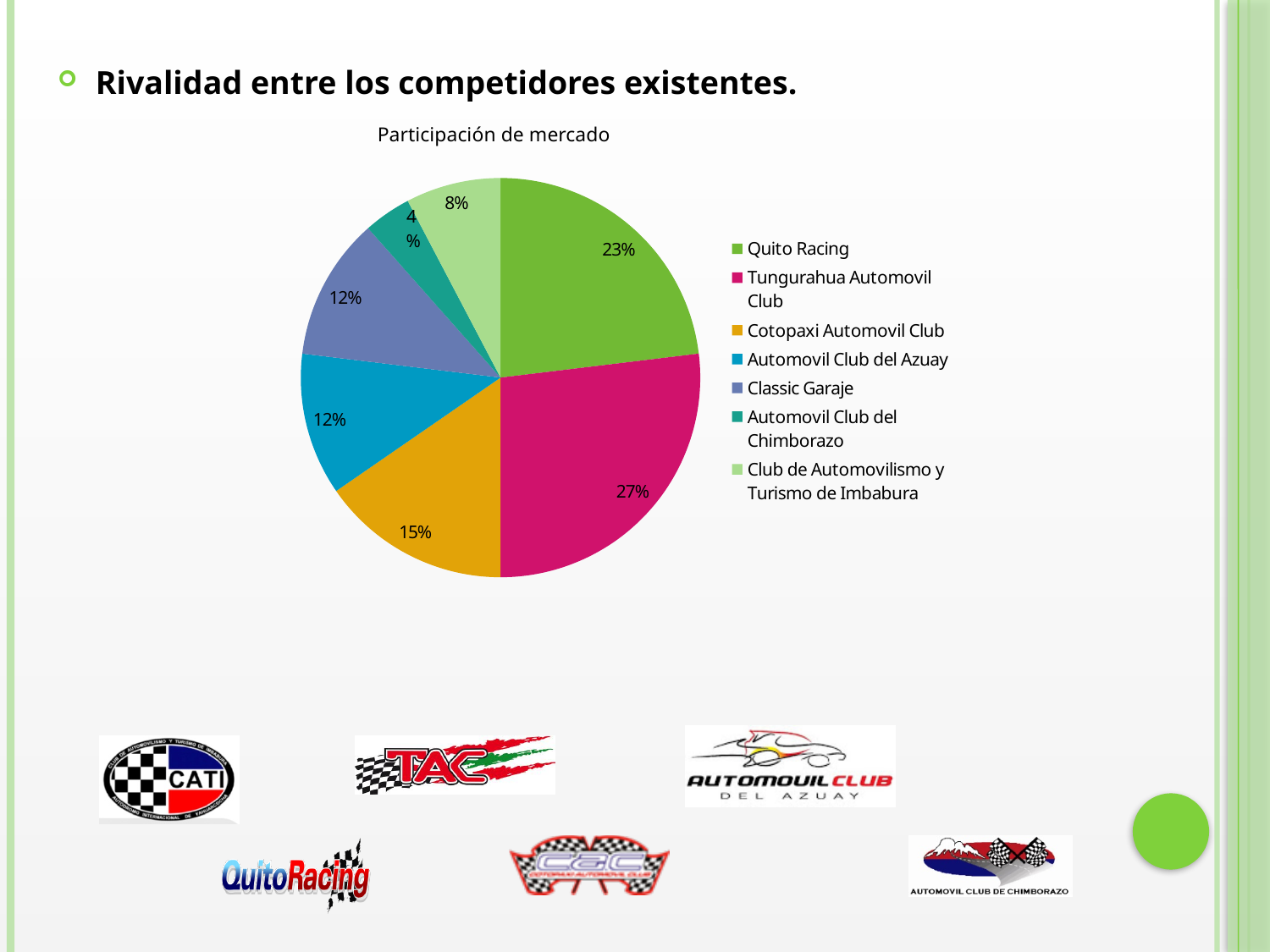
How many percentage points larger is Tungurahua Automovil Club's share than Quito Racing's? 4 Which has a larger market share, Cotopaxi Automovil Club or Classic Garaje? Cotopaxi Automovil Club What share of the market does Club de Automovilismo y Turismo de Imbabura hold? 8% What share of the market does Quito Racing hold? 23% What share of the market does Cotopaxi Automovil Club hold? 15% Which competitor has the smallest market share? Automovil Club del Chimborazo How many competitors are listed in the chart legend? 7 Which competitor has the largest market share? Tungurahua Automovil Club What kind of chart is shown on the slide? pie chart What share of the market does Automovil Club del Chimborazo hold? 4% What is the title of the chart? Participación de mercado What share of the market does Tungurahua Automovil Club hold? 27%